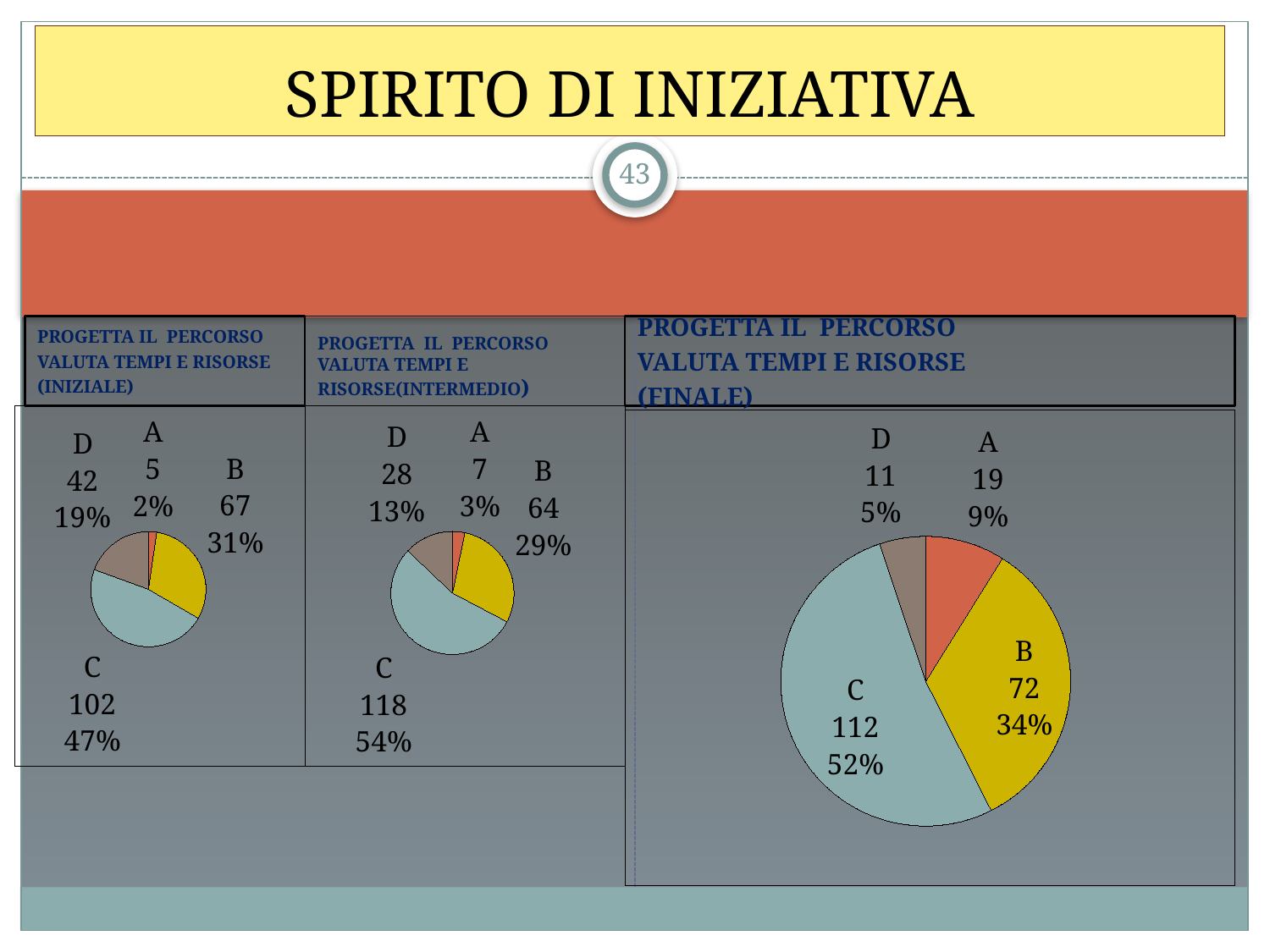
In the (INIZIALE) pie chart, what percentage share does category B have? 31% In the (INTERMEDIO) pie chart, which is larger, the value for B or the value for D? B In the (INTERMEDIO) pie chart, what is the value for category D? 28 In the (FINALE) pie chart, which category has the largest slice? C In the (INTERMEDIO) pie chart, which category has the smallest slice? A What kind of chart is used in the PROGETTA IL PERCORSO VALUTA TEMPI E RISORSE (FINALE) panel? pie chart In the (FINALE) pie chart, what percentage share does category A have? 9% In the (FINALE) pie chart, what is the value for category B? 72 How many pie charts are shown on the slide? 3 How many categories does the (INIZIALE) pie chart show? 4 In the (INIZIALE) pie chart, what is the value for category C? 102 In the (FINALE) pie chart, what is the difference between the values for C and B? 40